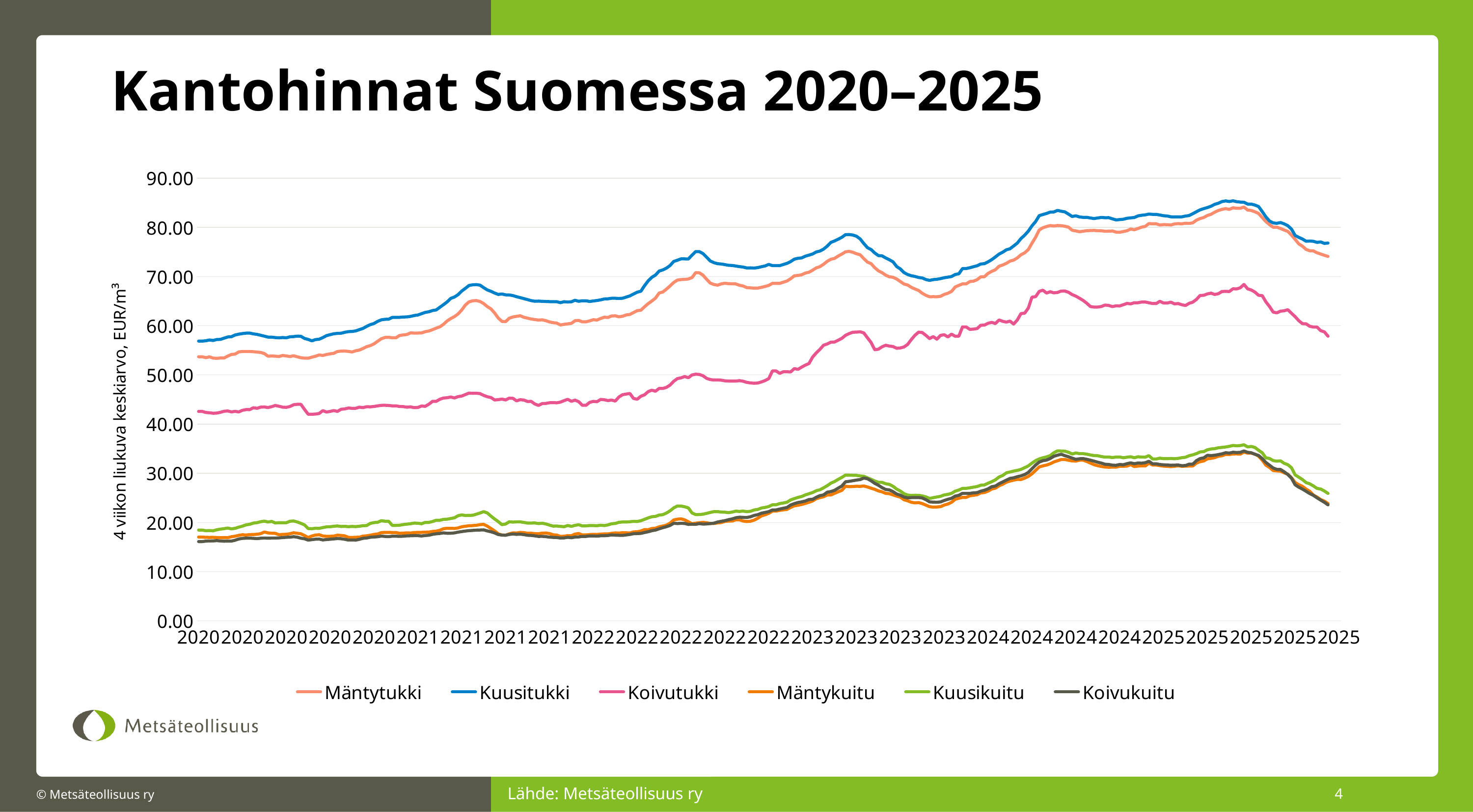
Is the peak value for Kuusitukki in 2025 greater or less than 80? greater How many series does the legend list? 6 What is the label of the vertical axis? 4 viikon liukuva keskiarvo, EUR/m³ Is the value for Mäntykuitu at the start of 2020 greater or less than 20? less Does the Koivutukki series generally rise or fall from 2020 to 2024? rise Is the value for Koivutukki at the start of 2020 greater or less than 40? greater Which series is higher throughout the period, Kuusitukki or Mäntytukki? Kuusitukki Which series reaches the highest value on the chart? Kuusitukki What kind of chart is shown on the slide? line chart What is the title of the chart? Kantohinnat Suomessa 2020–2025